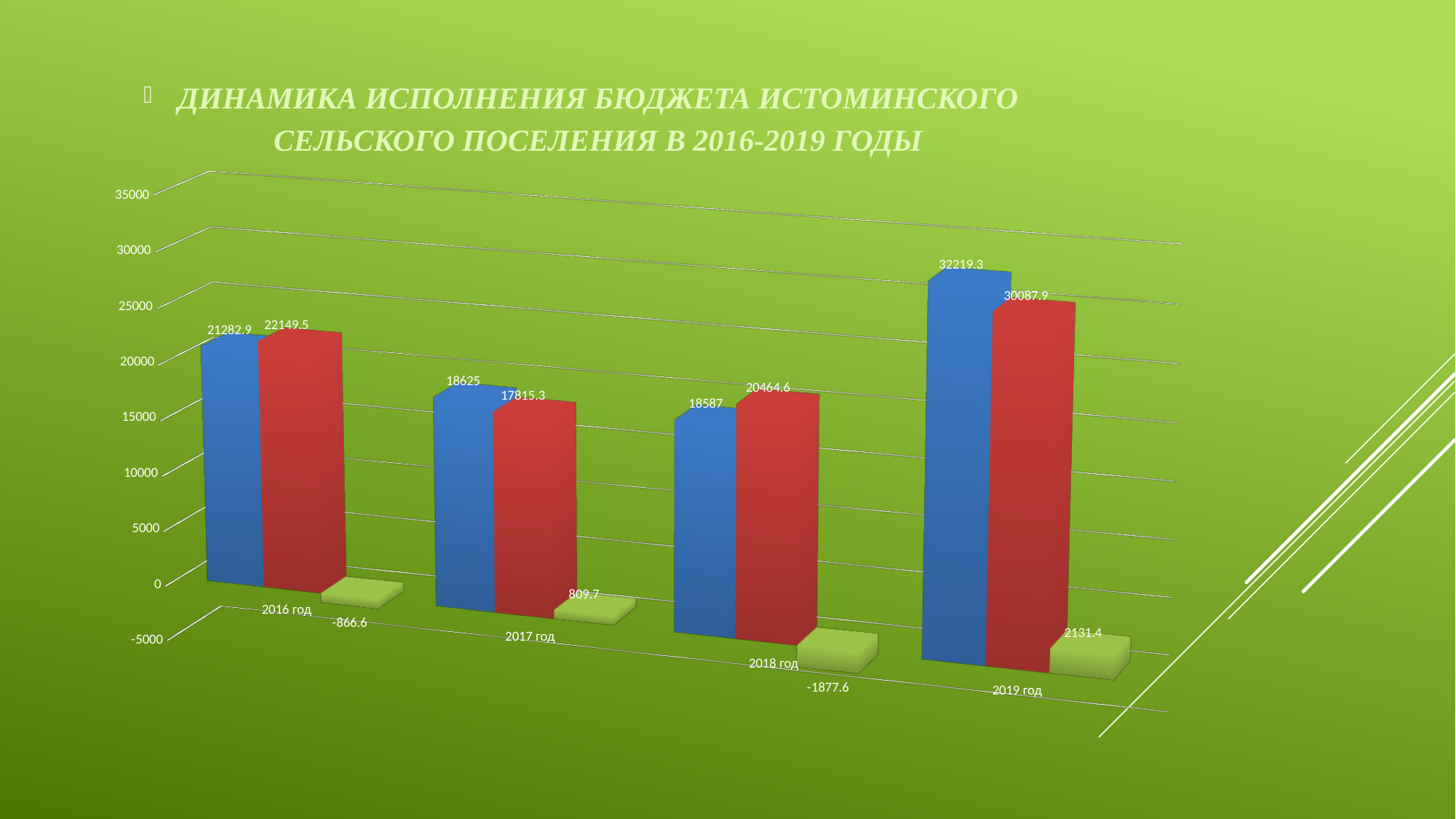
Which is larger for 2018 год, the blue bar or the red bar? the red bar What is the value of the green bar for 2018 год? -1877.6 Which year has the highest blue bar? 2019 год What is the title of the chart? ДИНАМИКА ИСПОЛНЕНИЯ БЮДЖЕТА ИСТОМИНСКОГО СЕЛЬСКОГО ПОСЕЛЕНИЯ В 2016-2019 ГОДЫ What kind of chart is shown on the slide? bar chart How many years are shown on the x axis? 4 What is the value of the red bar for 2017 год? 17815.3 Is the value of the red bar for 2019 год greater or less than 25000? greater What is the value of the blue bar for 2019 год? 32219.3 Which year has the lowest green bar? 2018 год What is the difference between the blue and red bars for 2019 год? 2131.4 What is the value of the red bar for 2016 год? 22149.5